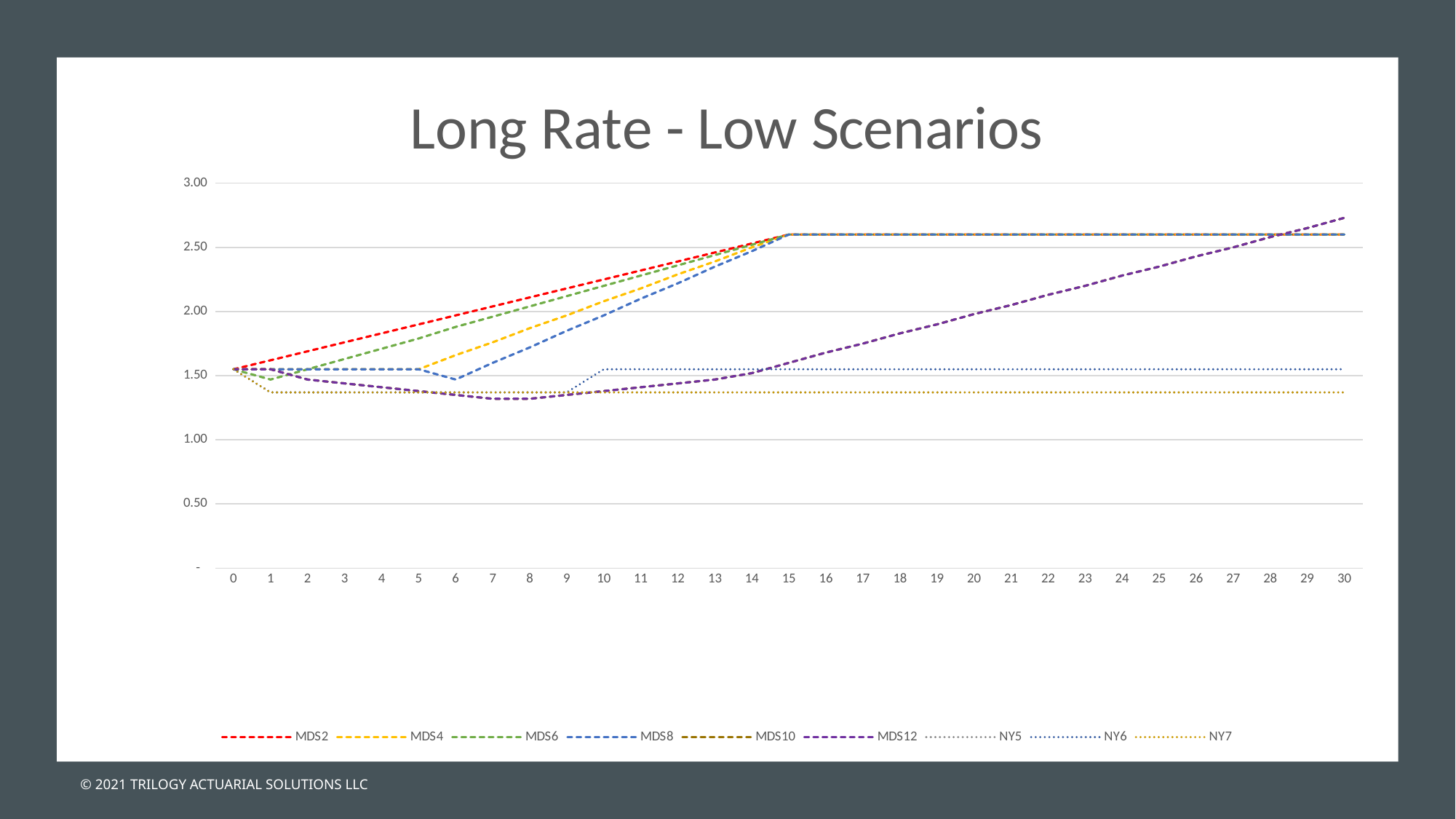
Does the MDS12 series rise or fall between x = 10 and x = 30? rise How many points are labelled along the x axis? 31 Is the value for NY7 at x = 30 greater or less than 1.50? less Is the value for MDS2 at x = 15 greater or less than 2.00? greater Which series has the highest value at x = 30? MDS10 and MDS12 (tied) Which series has the lowest value at x = 30? NY5 and NY7 (tied) How many series does the legend list? 9 Is the value for MDS12 at x = 30 greater or less than 2.50? greater What kind of chart is shown on the slide? line chart At x = 30, which series has the higher value, MDS12 or NY6? MDS12 What is the title of the chart? Long Rate - Low Scenarios